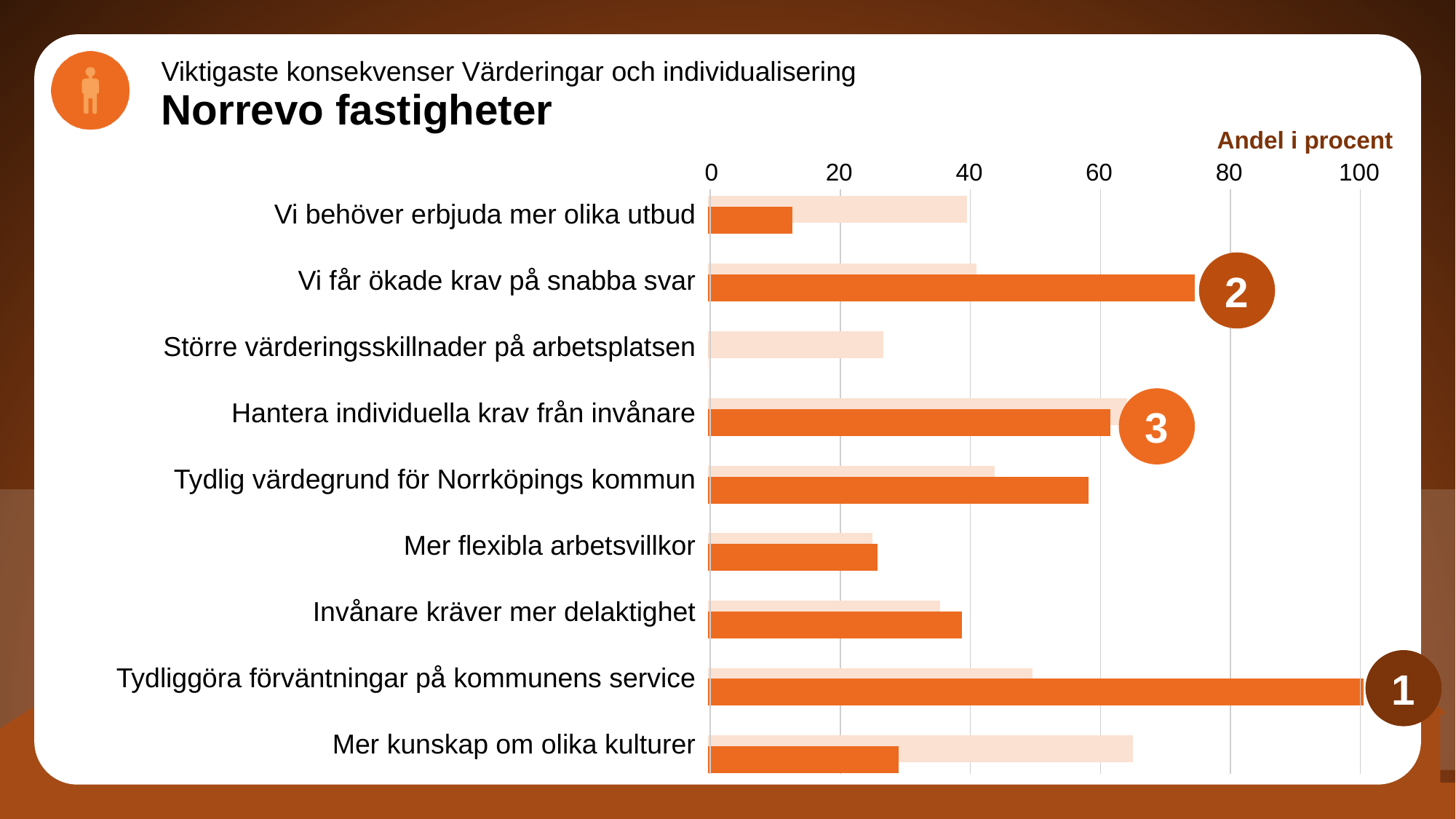
Is the dark orange bar for 'Vi behöver erbjuda mer olika utbud' greater or less than 20? less Is the dark orange bar for 'Mer kunskap om olika kulturer' greater or less than 40? less Which has the longer light orange bar: 'Mer kunskap om olika kulturer' or 'Vi behöver erbjuda mer olika utbud'? Mer kunskap om olika kulturer What label is shown above the horizontal axis of the chart? Andel i procent Which has the longer dark orange bar: 'Vi får ökade krav på snabba svar' or 'Tydlig värdegrund för Norrköpings kommun'? Vi får ökade krav på snabba svar Is the light orange bar for 'Mer kunskap om olika kulturer' greater or less than 60? greater What kind of chart is shown on the slide? bar chart Which category has the longest dark orange bar? Tydliggöra förväntningar på kommunens service How many categories are listed on the chart? 9 What value does the dark orange bar for 'Tydliggöra förväntningar på kommunens service' reach? 100 What number is shown in the circle next to the bar for 'Tydliggöra förväntningar på kommunens service'? 1